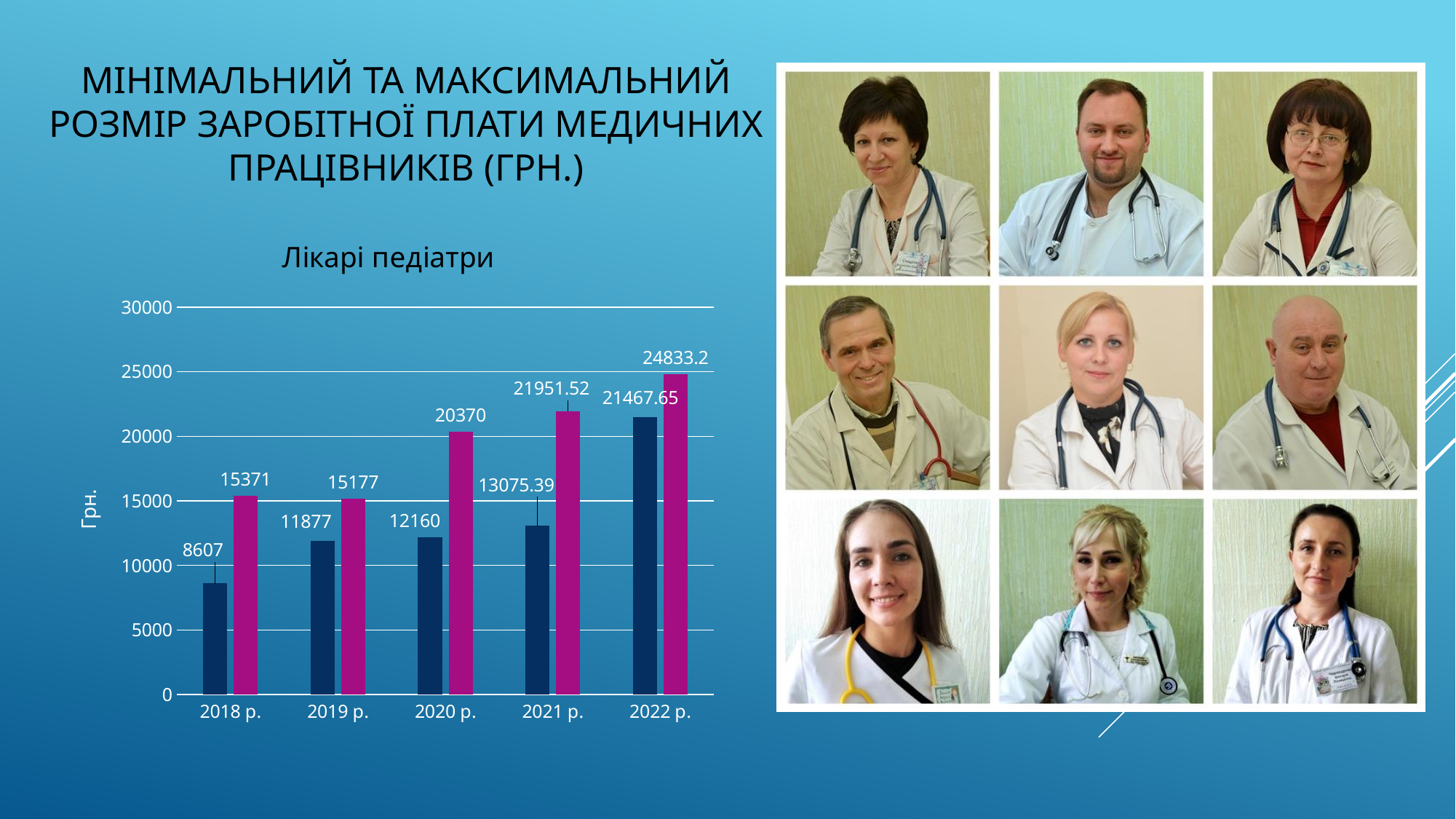
Which year has the larger magenta bar value, 2018 р. or 2019 р.? 2018 р. What is the difference between the magenta bar and the dark blue bar for 2020 р.? 8210 What is the title of the chart? Лікарі педіатри What kind of chart is shown on the slide? bar chart In which year is the magenta bar the highest? 2022 р. In which year is the dark blue bar the lowest? 2018 р. What is the value of the magenta bar for 2022 р.? 24833.2 Do the dark blue bars rise or fall from 2018 р. to 2022 р.? rise What is the value of the dark blue bar for 2018 р.? 8607 What is the value of the dark blue bar for 2021 р.? 13075.39 How many years are shown on the x axis of the chart? 5 Is the value of the dark blue bar for 2022 р. greater or less than 20000? greater